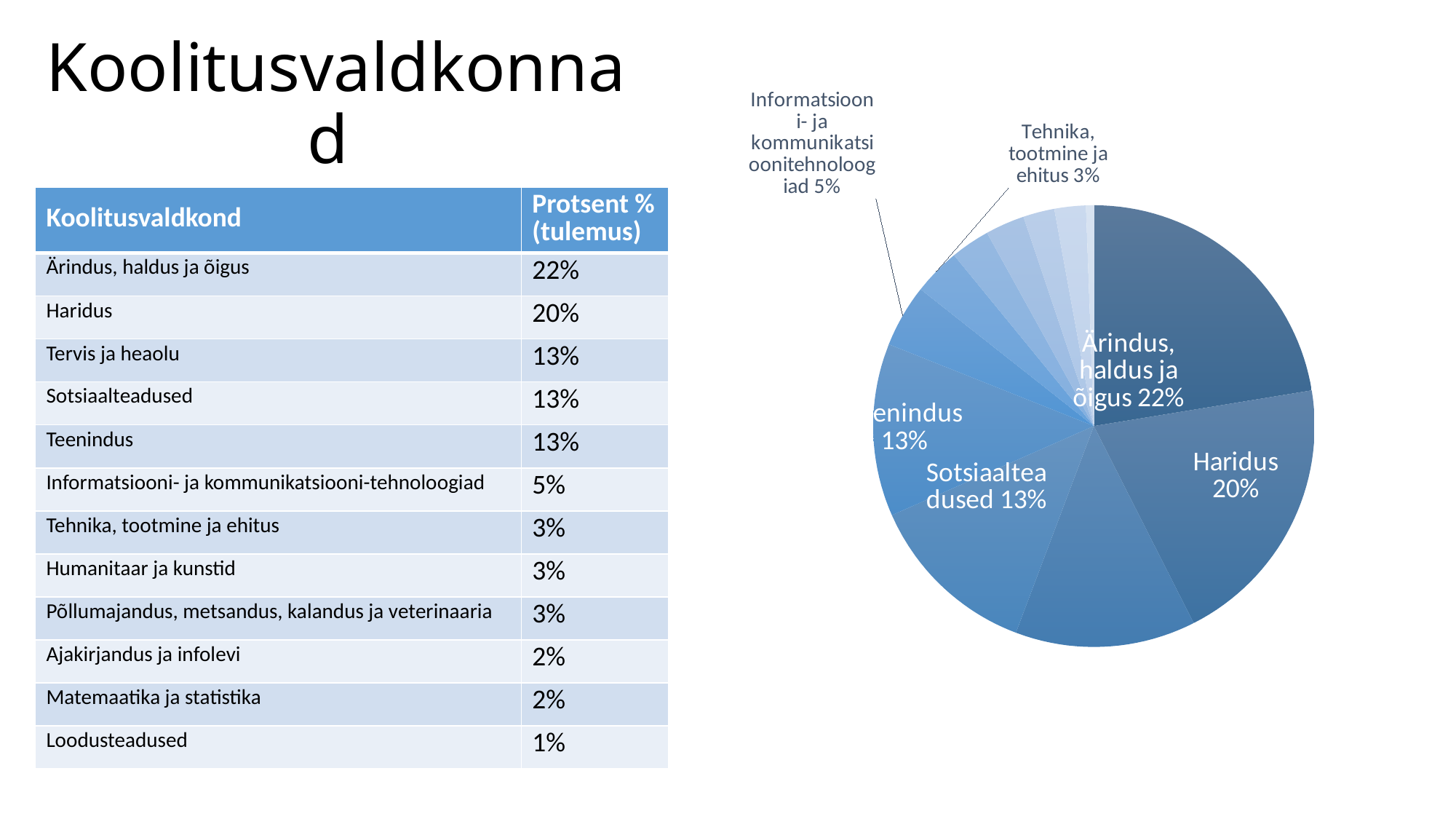
In the pie chart, what share does the Haridus slice have? 20% What is the difference between the Haridus slice and the Tehnika, tootmine ja ehitus slice? 17% What is the difference between the Ärindus, haldus ja õigus slice and the Haridus slice? 2% In the pie chart, what is the value for Tehnika, tootmine ja ehitus? 3% In the pie chart, what is the value for Ärindus, haldus ja õigus? 22% In the pie chart, what is the value for Informatsiooni- ja kommunikatsioonitehnoloogiad? 5% What kind of chart is shown on the right of the slide? pie chart In the pie chart, what is the value for Sotsiaaltea­dused? 13% Which category has the largest slice in the pie chart? Ärindus, haldus ja õigus What is the title of the slide containing the pie chart? Koolitusvaldkonnad Which slice is larger in the pie chart: Informatsiooni- ja kommunikatsioonitehnoloogiad or Tehnika, tootmine ja ehitus? Informatsiooni- ja kommunikatsioonitehnoloogiad Which slice is larger in the pie chart: Haridus or Sotsiaalteadused? Haridus